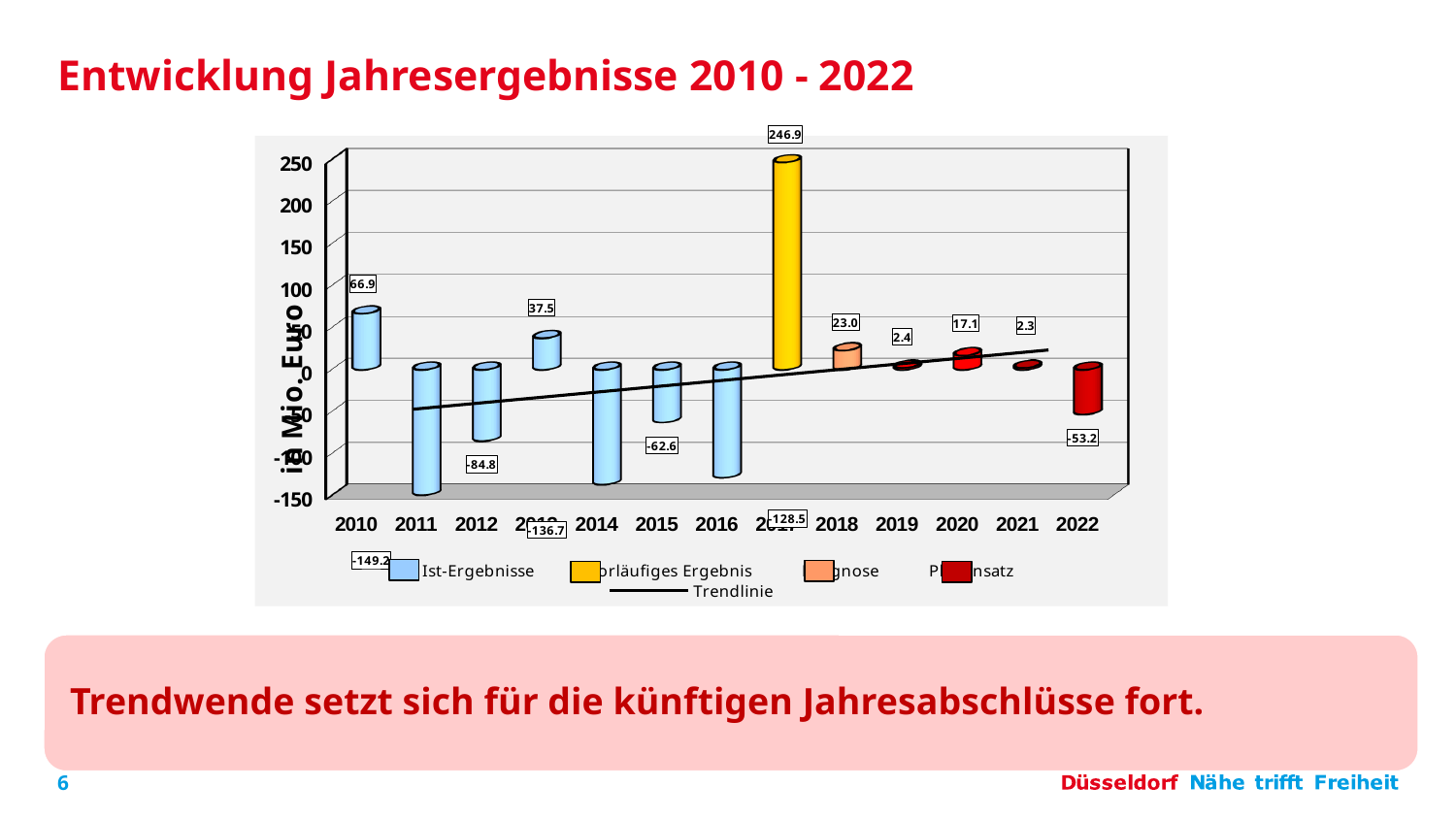
What is the label of the vertical axis of the chart? in Mio. Euro What kind of chart is shown on the slide? bar chart What is the value for 2022 in the chart? -53.2 What is the value for 2017 in the chart? 246.9 What is the difference between the values for 2010 and 2013? 29.4 What is the value for 2010 in the chart? 66.9 How many entries does the chart legend list? 5 How many years are shown on the x axis of the chart? 13 Which year has the highest value in the chart? 2017 Which year has the lowest value in the chart? 2011 Is the value for 2017 greater or less than 200? greater Which year has the larger value, 2018 or 2020? 2018